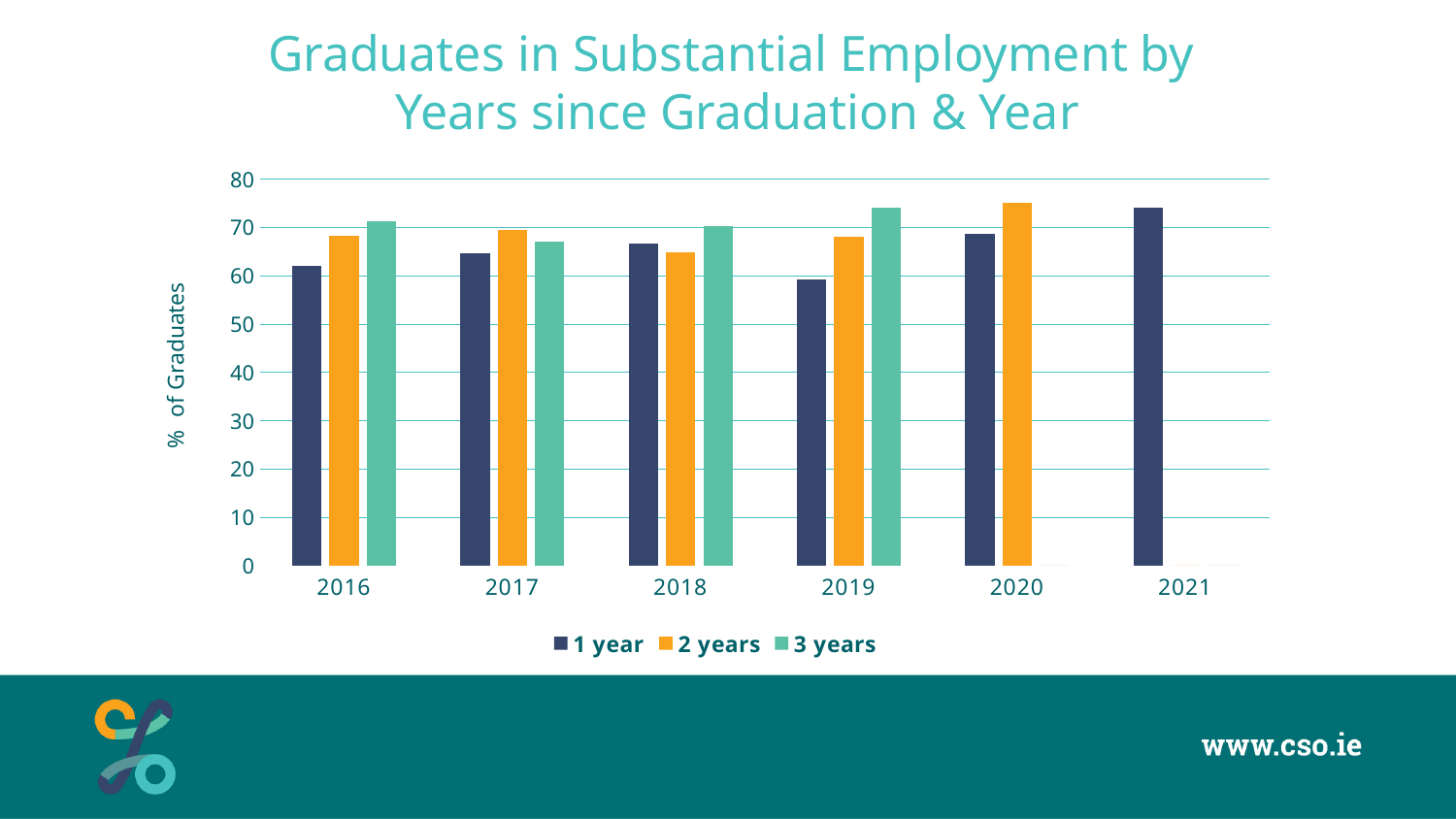
In which year is the 1 year bar the highest? 2021 Is the value for 3 years in 2019 greater or less than 70? greater Is the value for 1 year in 2019 greater or less than 70? less Does the 1 year series rise or fall from 2019 to 2021? rise How many series does the legend list? 3 In 2016, which is larger: the 1 year value or the 3 years value? 3 years What is the label on the y axis? % of Graduates How many years are shown along the x axis? 6 Is the value for 2 years in 2020 greater or less than 70? greater What kind of chart is shown on the slide? bar chart In which year is the 1 year bar the lowest? 2019